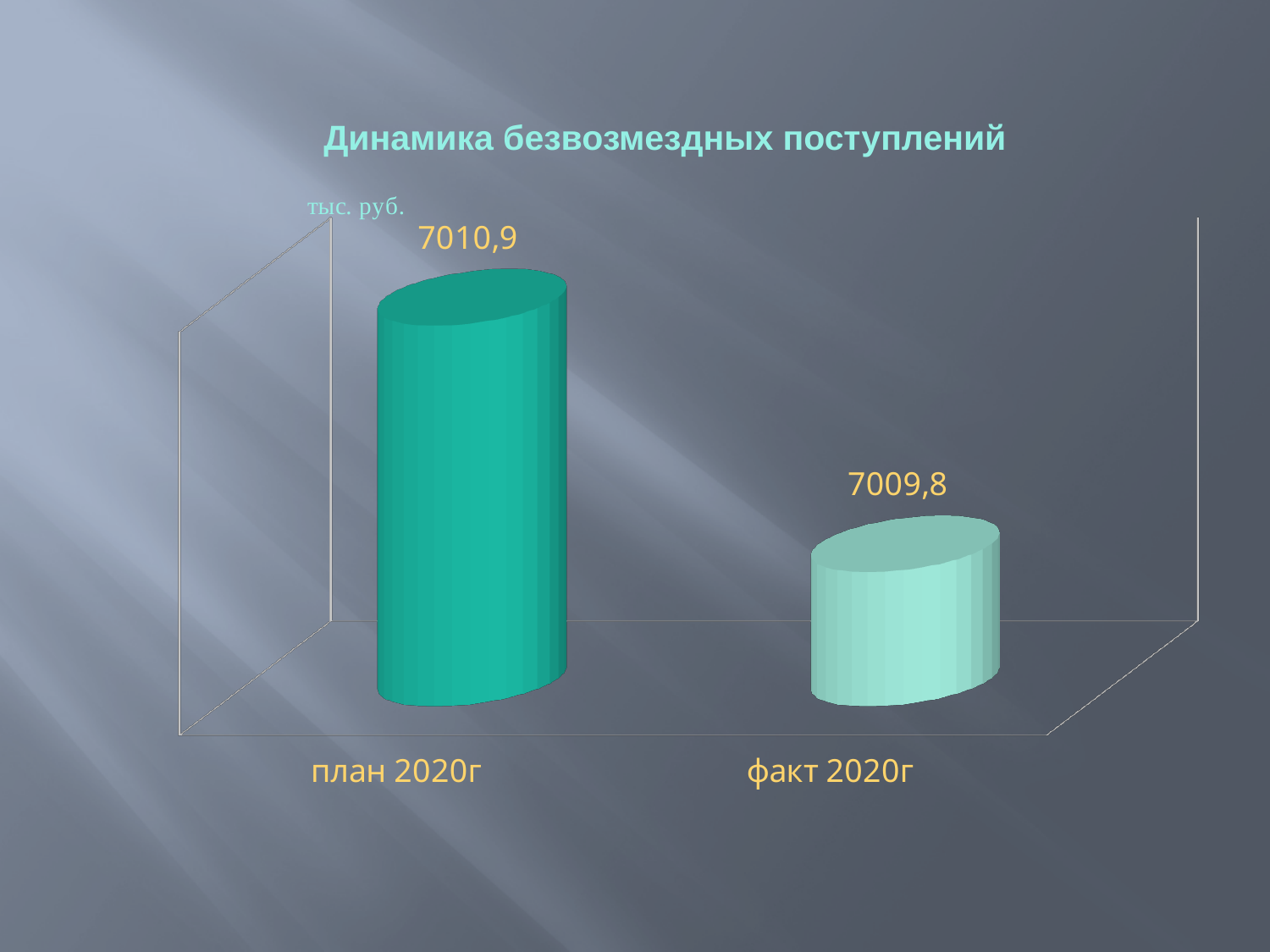
Which category has the highest value? план 2020г Do the values rise or fall from план 2020г to факт 2020г? fall What kind of chart is shown on the slide? bar chart What is the title of the chart? Динамика безвозмездных поступлений What is the value for план 2020г? 7010,9 What is the value for факт 2020г? 7009,8 Which is larger, the value for план 2020г or the value for факт 2020г? план 2020г Which category has the lowest value? факт 2020г What is the difference between the values for план 2020г and факт 2020г? 1,1 What unit is shown on the chart? тыс. руб. How many categories are shown on the chart? 2